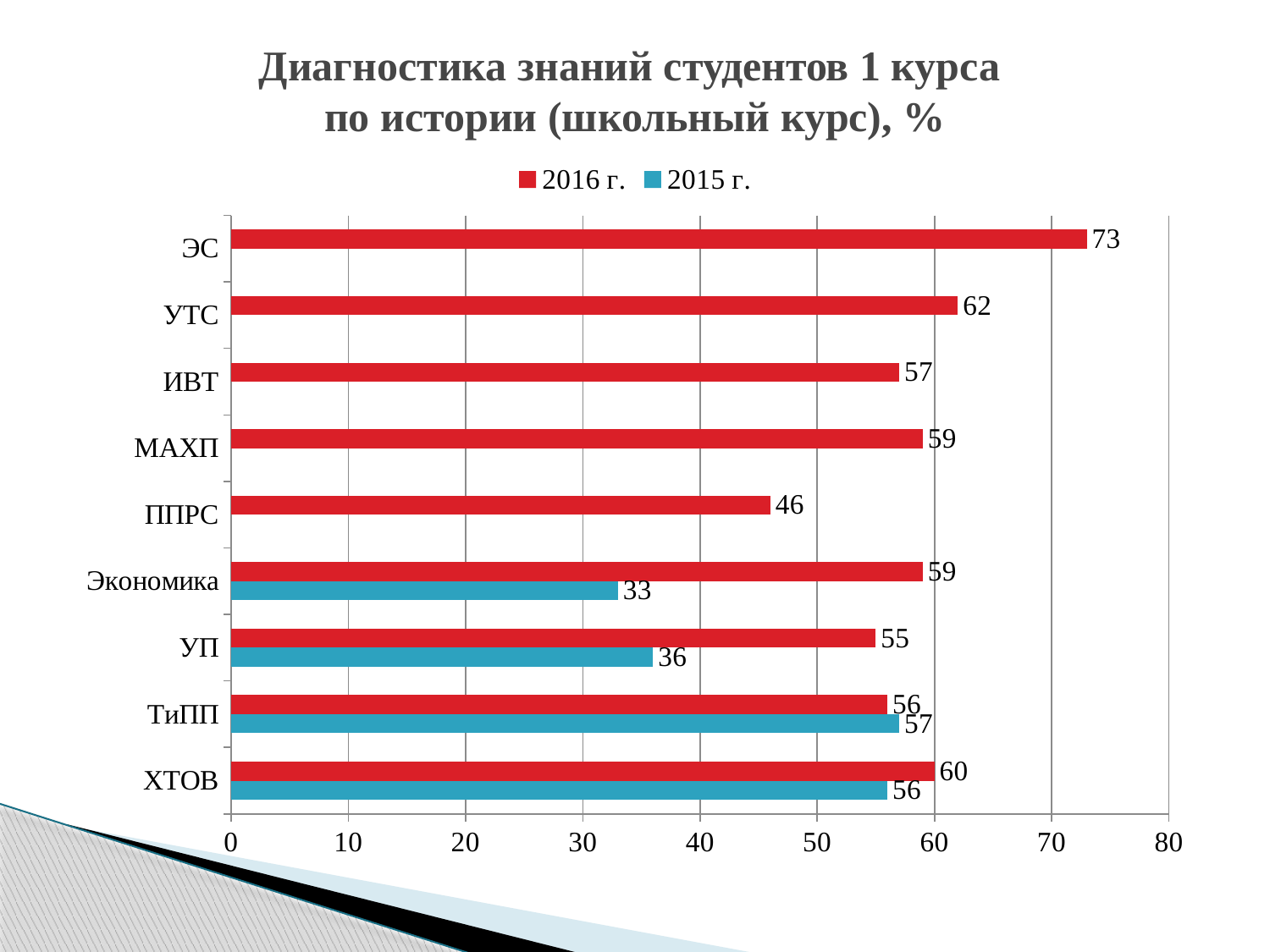
What is the 2015 г. value for ТиПП? 57 Which category has the highest 2016 г. value? ЭС What kind of chart is shown on the slide? Bar chart How many categories are shown on the vertical axis? 9 What is the 2015 г. value for Экономика? 33 How many series does the legend list? 2 Which category has the lowest 2015 г. value? Экономика What is the difference between the 2016 г. and 2015 г. values for УП? 19 What is the 2016 г. value for ППРС? 46 Which is larger for ХТОВ: the 2016 г. value or the 2015 г. value? 2016 г. Which category has the lowest 2016 г. value? ППРС What is the 2016 г. value for ЭС? 73